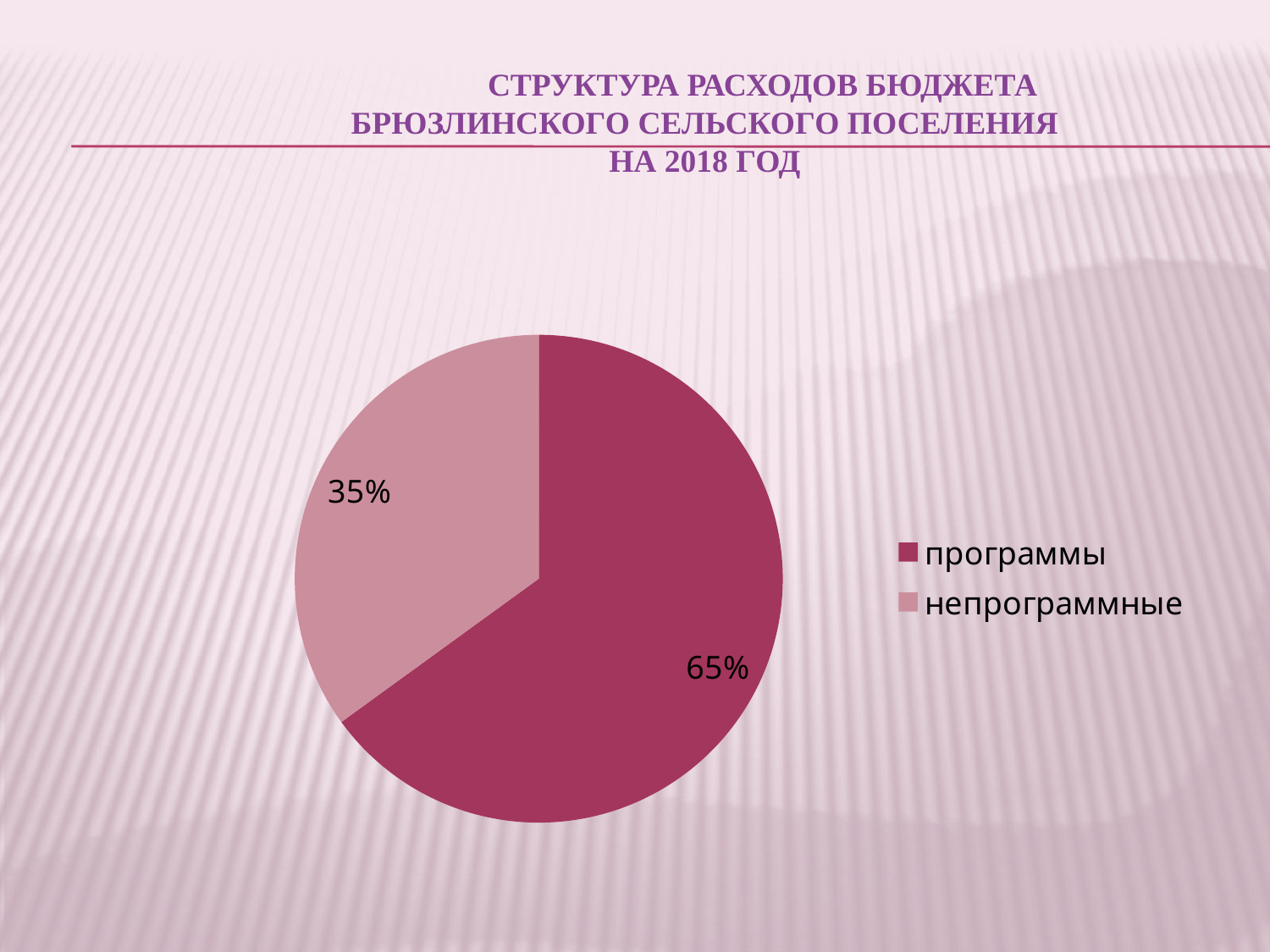
What share of the pie does the "непрограммные" slice represent? 35% What is the difference in percentage points between the "программы" and "непрограммные" slices? 30 percentage points Which is larger, the "программы" slice or the "непрограммные" slice? программы How many entries does the legend list? 2 What share of the pie does the "программы" slice represent? 65% What kind of chart is shown on the slide? pie chart What year does the chart title refer to? 2018 Which category is shown in the lighter pink colour? непрограммные How many categories are shown in the pie chart? 2 Which category has the smallest slice of the pie? непрограммные Which category has the largest slice of the pie? программы